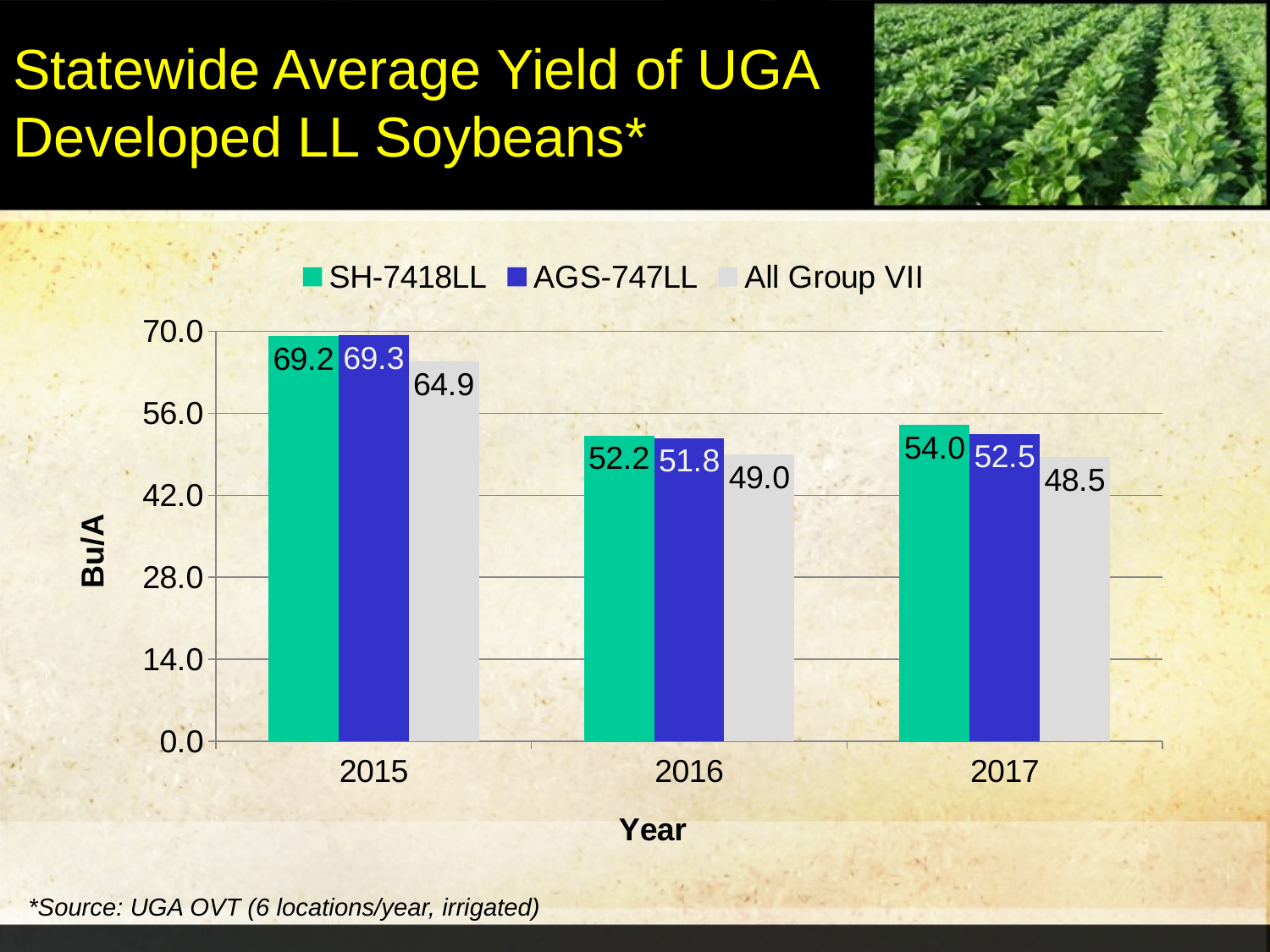
How many series does the legend list? 3 What is the difference between the AGS-747LL yield in 2015 and in 2016? 17.5 Which is larger in 2016, the SH-7418LL yield or the All Group VII yield? SH-7418LL In which year is the SH-7418LL yield highest? 2015 What is the yield for All Group VII in 2017? 48.5 What is the difference between the SH-7418LL yield and the All Group VII yield in 2017? 5.5 How many years are shown on the x axis? 3 What is the yield for AGS-747LL in 2016? 51.8 What kind of chart is shown on the slide? bar chart What is the yield for SH-7418LL in 2015? 69.2 What is the label of the y axis? Bu/A In which year is the All Group VII yield lowest? 2017